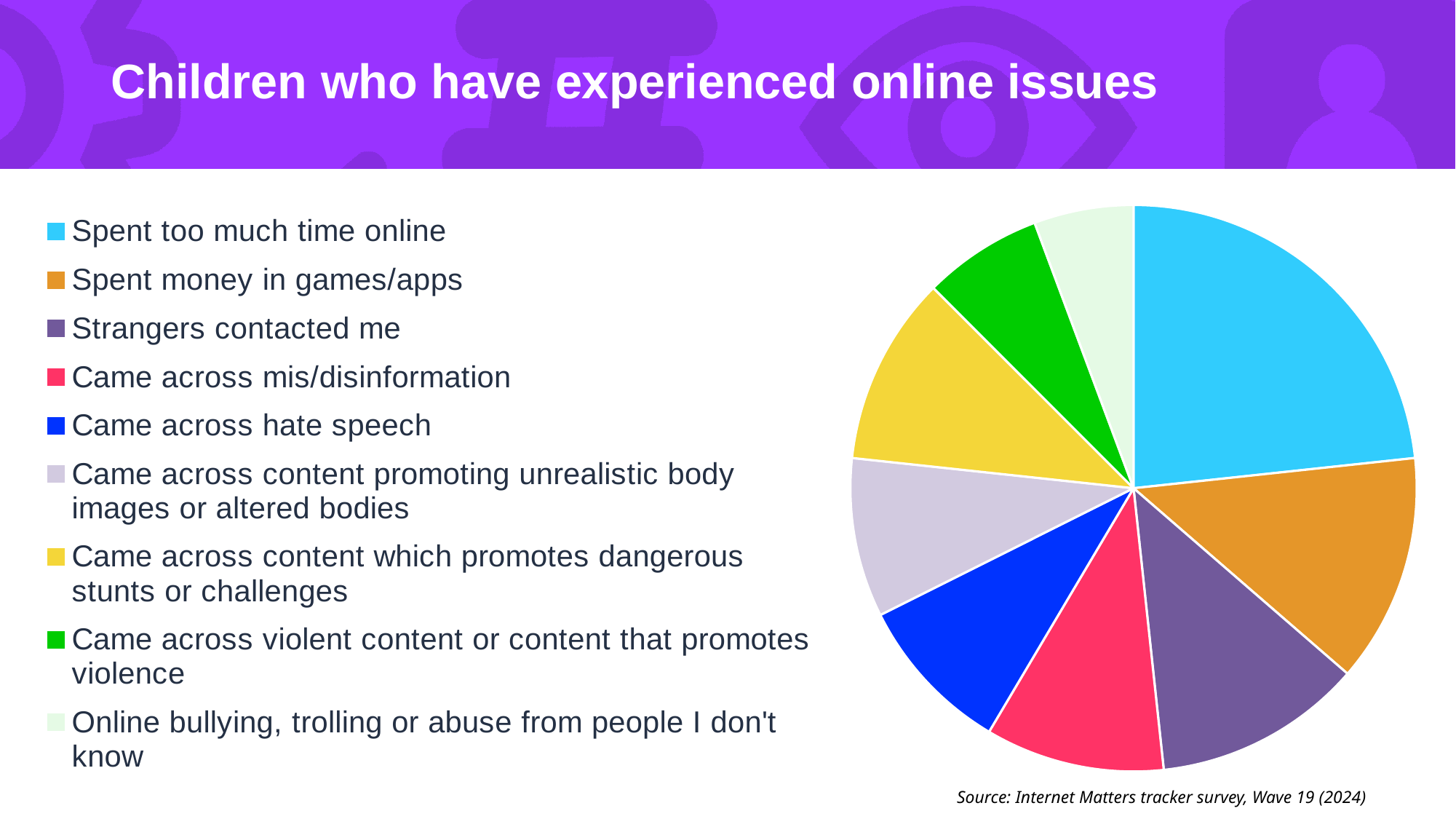
Which category has the largest slice of the pie chart? Spent too much time online Which slice is larger: "Strangers contacted me" or "Came across violent content or content that promotes violence"? Strangers contacted me What colour is the slice for "Came across mis/disinformation"? pink Which slice is larger: "Spent too much time online" or "Came across hate speech"? Spent too much time online Which slice is larger: "Spent money in games/apps" or "Online bullying, trolling or abuse from people I don't know"? Spent money in games/apps How many categories (slices) does the pie chart have? 9 What kind of chart is shown on the slide? pie chart What is the title of the slide's chart? Children who have experienced online issues